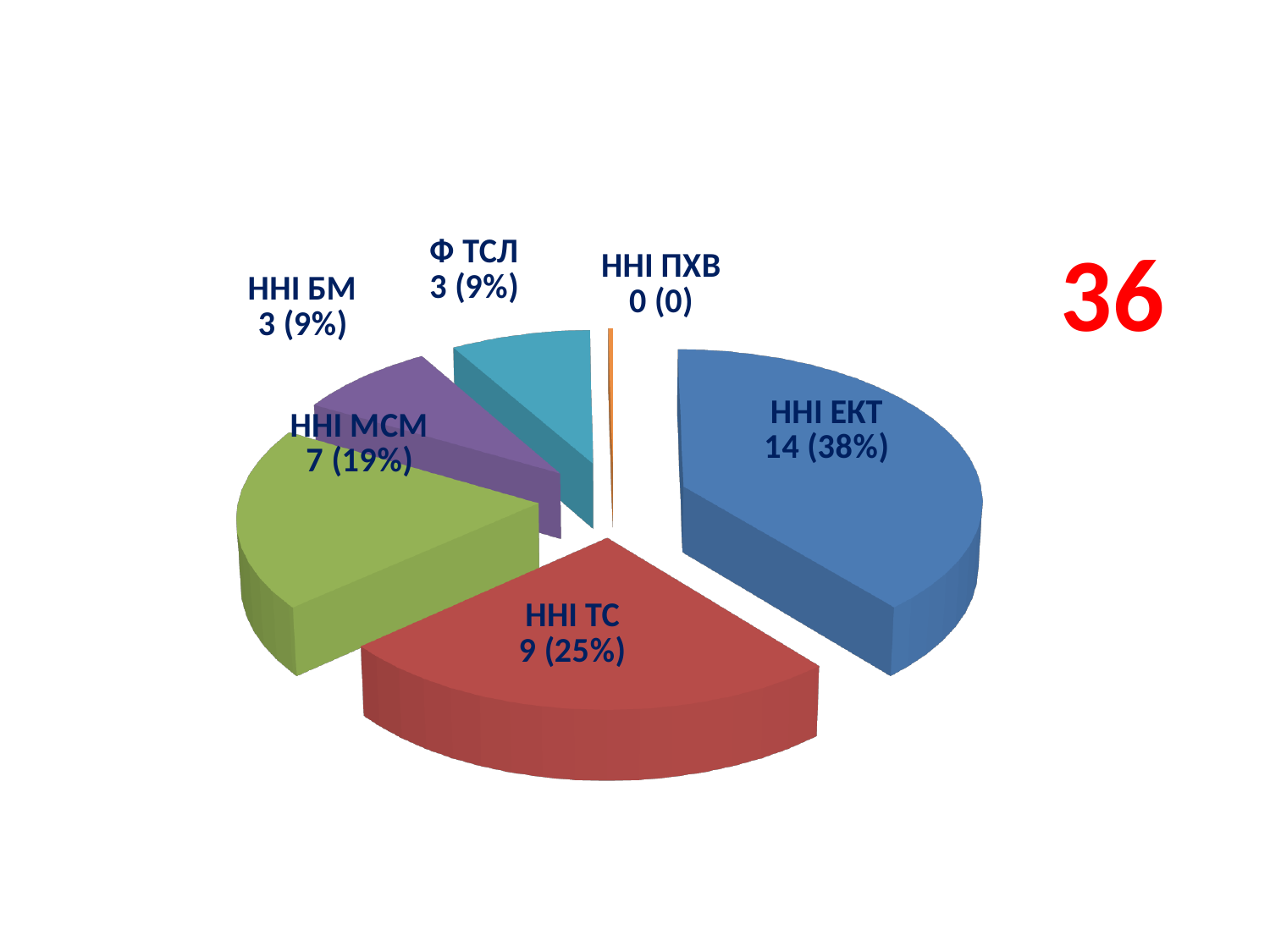
Which category has the largest slice of the pie? ННІ ЕКТ Which category has the smallest slice of the pie? ННІ ПХВ What value is shown for ННІ ПХВ? 0 (0) What value is shown for ННІ МСМ? 7 (19%) What kind of chart is shown on the slide? pie chart What number is printed in red in the top right corner of the slide? 36 What value is shown for ННІ ТС? 9 (25%) How many categories does the pie chart show? 6 Which is larger, the value for ННІ МСМ or the value for ННІ БМ? ННІ МСМ What value is shown for ННІ ЕКТ? 14 (38%) What is the difference between the counts for ННІ ЕКТ and ННІ ТС? 5 What share of the pie does ННІ ТС represent? 25%